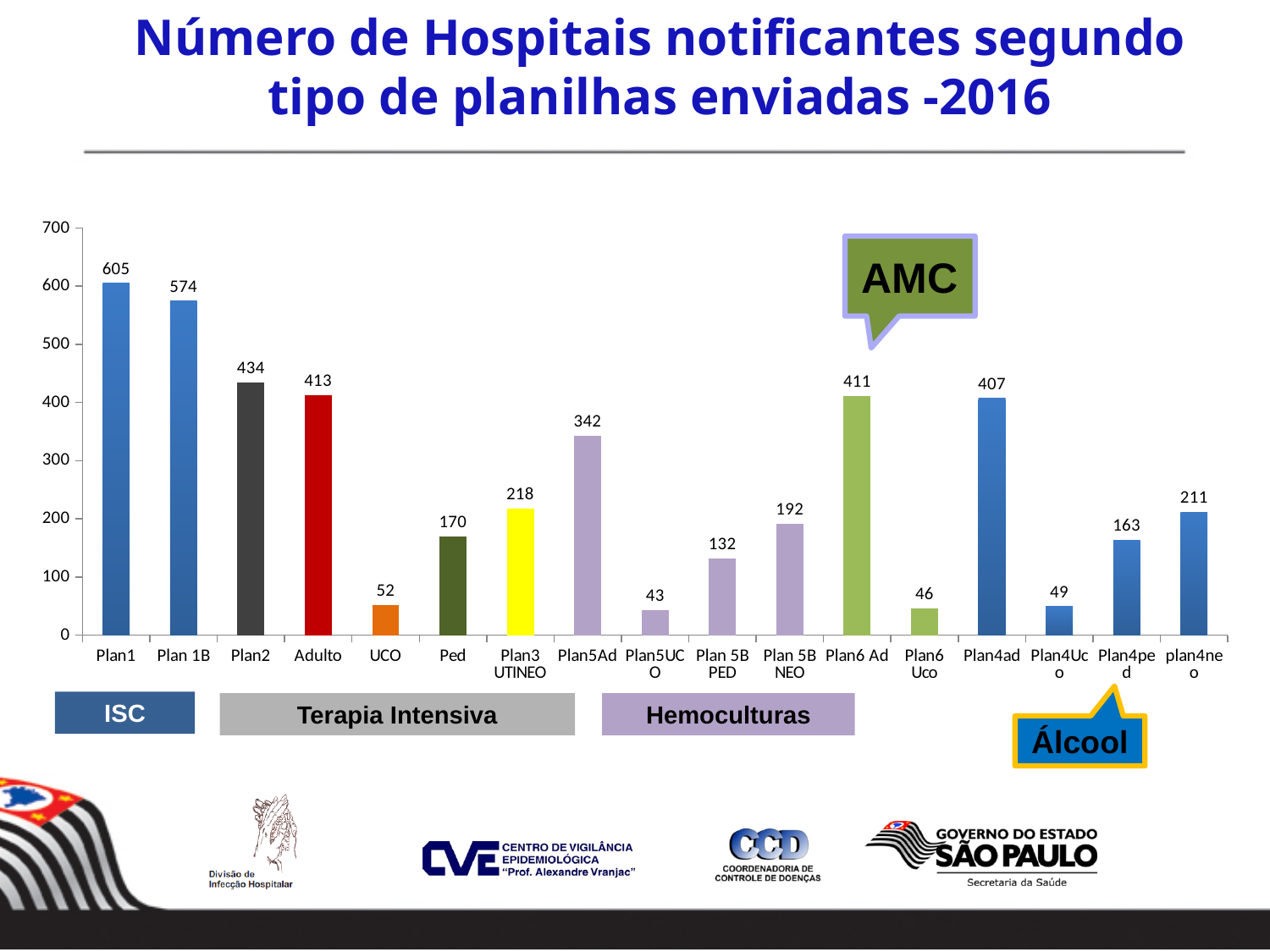
What is the difference between the values for Plan1 and Plan 1B? 31 What is the value for Plan5UCO? 43 What is the title of the chart? Número de Hospitais notificantes segundo tipo de planilhas enviadas -2016 What kind of chart is shown on the slide? Bar chart What is the value for Plan1? 605 Which is larger, the value for Plan2 or the value for Adulto? Plan2 Which category has the highest value? Plan1 What is the value for Plan 1B? 574 Which category has the lowest value? Plan5UCO Is the value for Plan5Ad greater or less than 300? greater How many categories are shown on the x axis? 17 What is the value for Plan6 Ad? 411